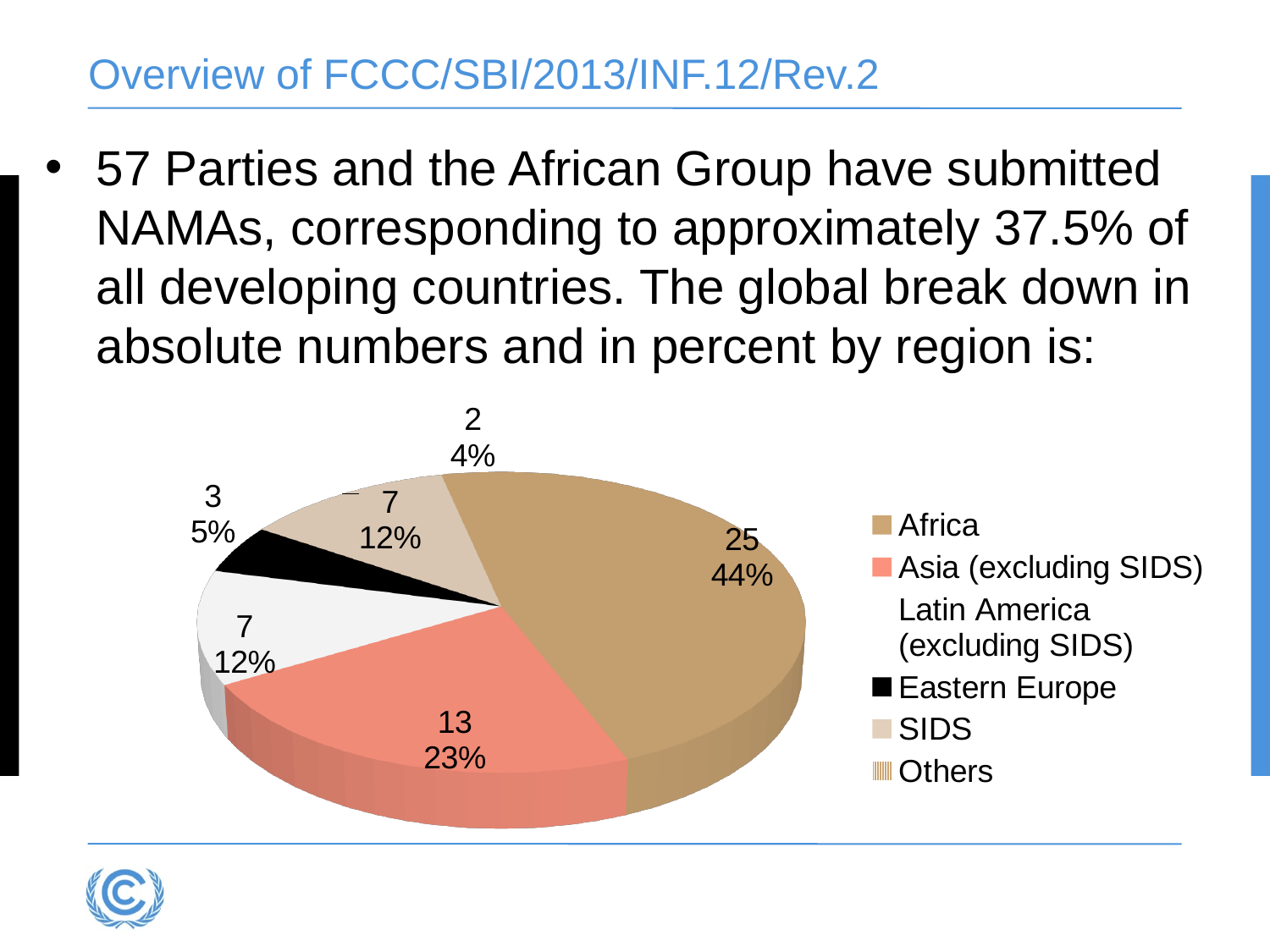
What percentage share does Others have in the pie chart? 4% How many entries does the legend of the pie chart list? 6 What kind of chart is shown on the slide? pie chart Which is larger in the pie chart, the value for Eastern Europe or the value for Others? Eastern Europe What is the value for Eastern Europe in the pie chart? 3 What is the value for Asia (excluding SIDS) in the pie chart? 13 Which region has the largest slice in the pie chart? Africa What percentage share does Africa have in the pie chart? 44% What percentage share does Asia (excluding SIDS) have in the pie chart? 23% Which region has the smallest slice in the pie chart? Others What is the difference between the values for Africa and Asia (excluding SIDS)? 12 How many NAMAs were submitted by Africa according to the pie chart? 25